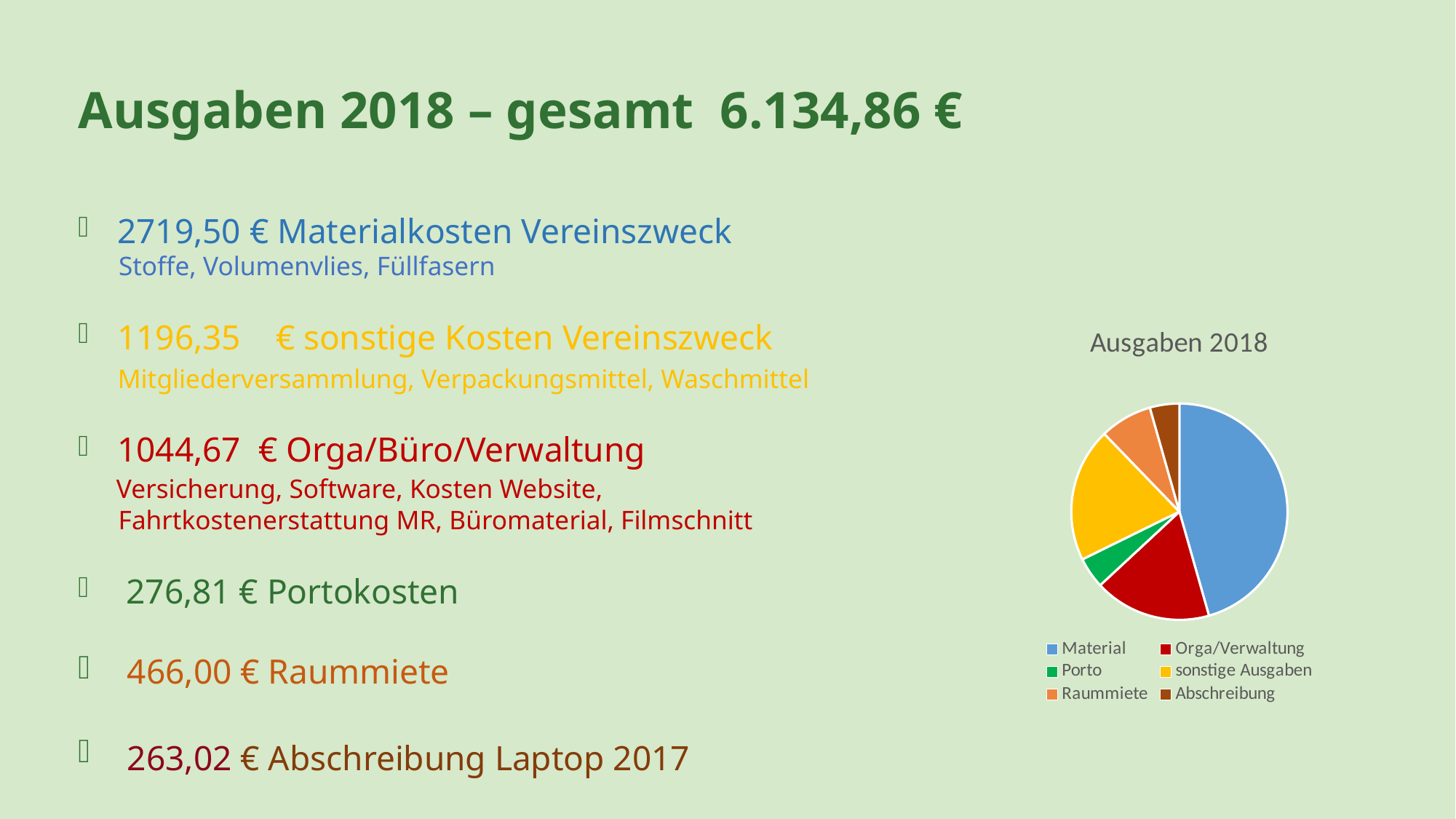
What kind of chart is shown on the slide? pie chart According to the slide, what is the total of the Ausgaben 2018 shown in the pie chart? 6.134,86 € How many entries does the legend of the pie chart list? 6 Which category has the largest slice in the pie chart? Material According to the slide text, what is the value of the Porto slice (Portokosten)? 276,81 € How many slices does the pie chart have? 6 According to the slide text, what is the value of the Raummiete slice? 466,00 € Which slice is larger, Material or Orga/Verwaltung? Material Which slice is larger, sonstige Ausgaben or Raummiete? sonstige Ausgaben What is the title of the pie chart? Ausgaben 2018 Which slice is larger, Orga/Verwaltung or Porto? Orga/Verwaltung What colour is the Material slice in the pie chart? blue